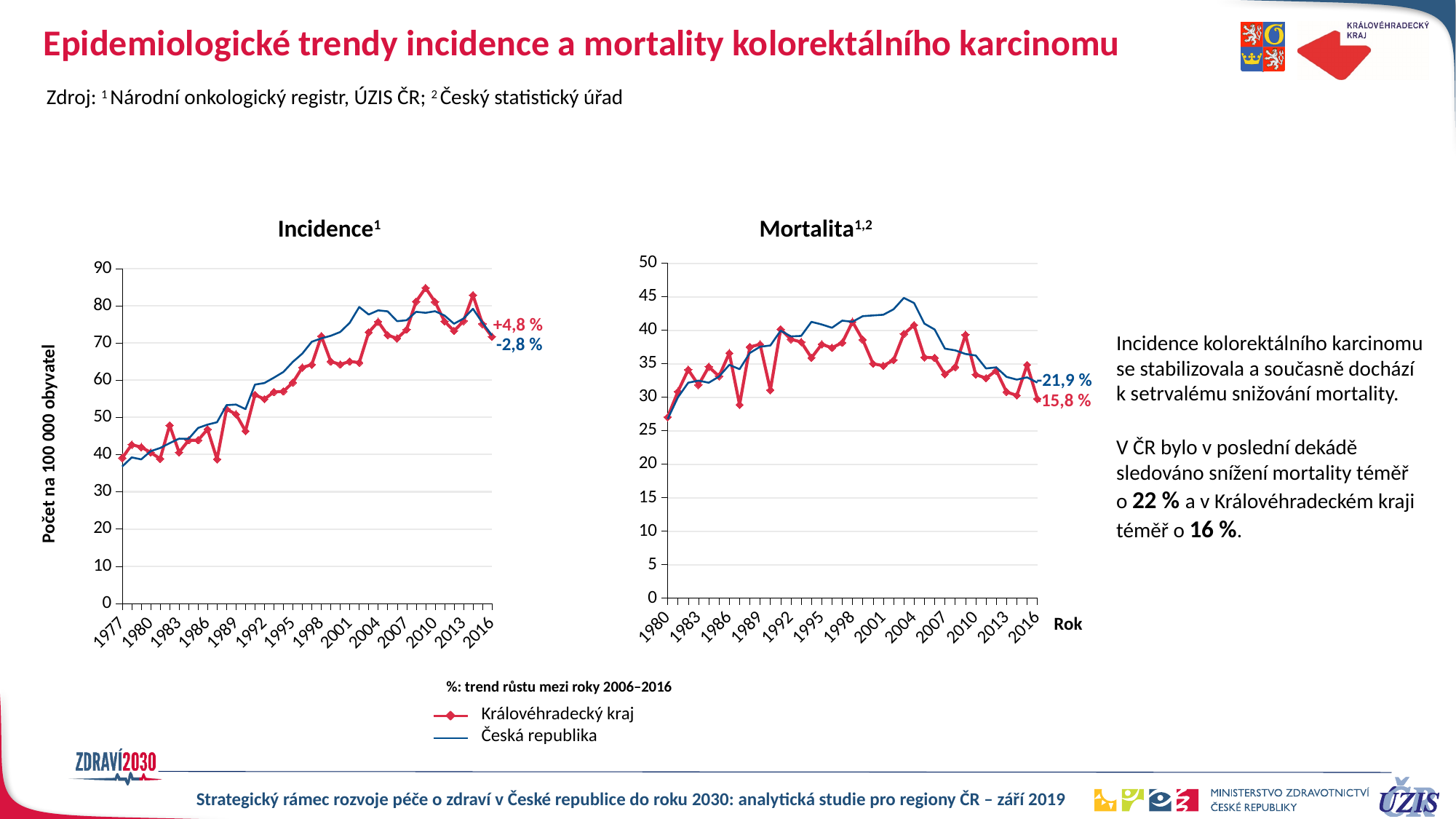
In the Incidence chart, does the Česká republika line rise or fall between 1977 and 2010? rise In the Incidence chart, what growth trend between 2006 and 2016 is printed for Královéhradecký kraj? +4,8 % In the Mortalita chart, is the value for Královéhradecký kraj in 1980 greater or less than 30? less In the Incidence chart, is the value for Královéhradecký kraj in 2010 greater or less than 80? greater In the Mortalita chart, what growth trend between 2006 and 2016 is printed for Česká republika? -21,9 % What kind of chart is the Incidence chart? line chart In the Incidence chart, what growth trend between 2006 and 2016 is printed for Česká republika? -2,8 % What is the label of the vertical axis on the Incidence chart? Počet na 100 000 obyvatel In the Mortalita chart, is the value for Česká republika in 2004 greater or less than 40? greater How many series does the legend list for the charts? 2 In the Mortalita chart, does the Česká republika line rise or fall between 2004 and 2016? fall In the Mortalita chart, what growth trend between 2006 and 2016 is printed for Královéhradecký kraj? -15,8 %